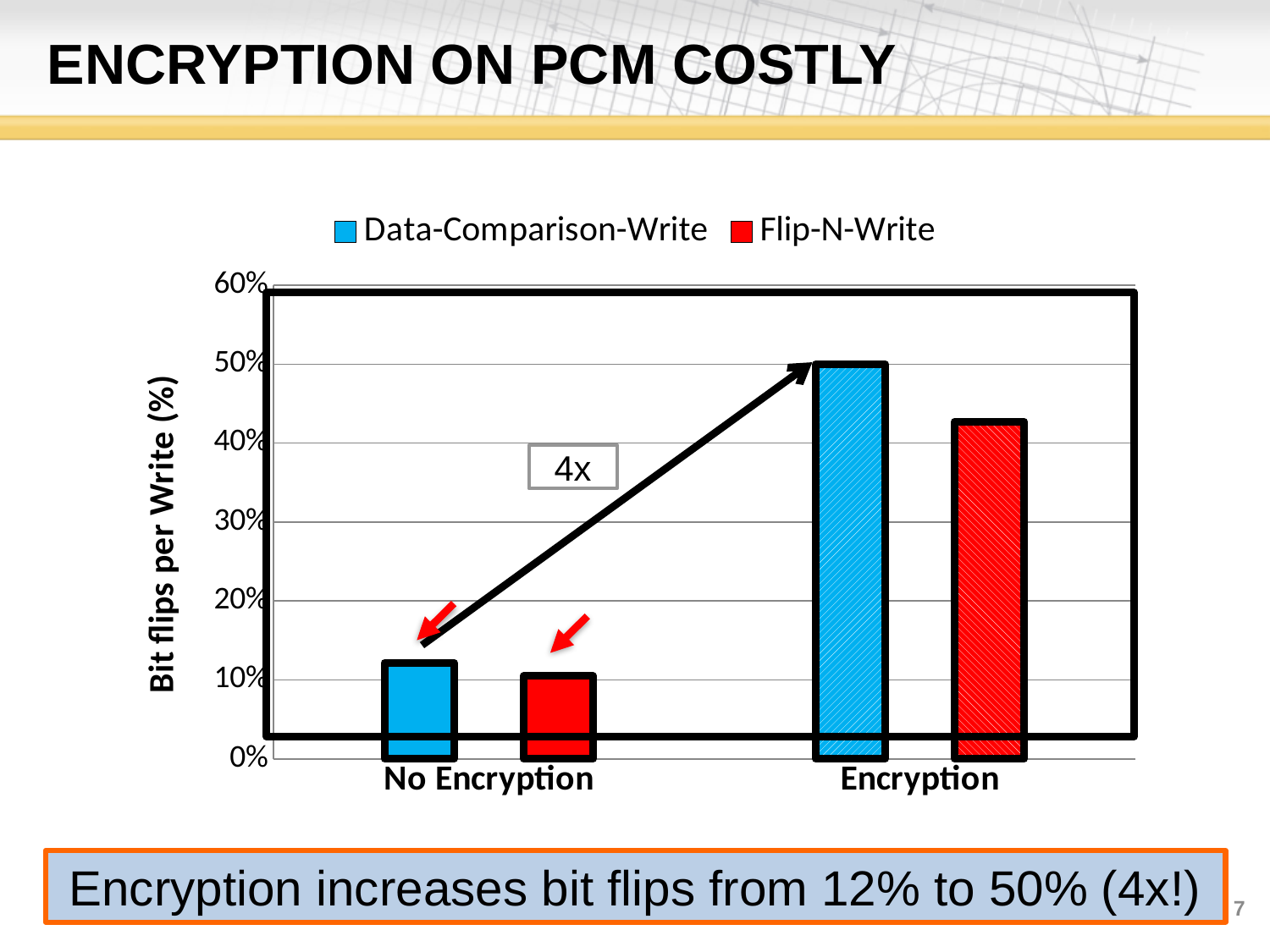
How many series does the legend list? 2 Which category has the highest Data-Comparison-Write value? Encryption How many categories are shown on the x axis? 2 Is the Flip-N-Write value for Encryption greater or less than 40%? greater For Encryption, which series has the larger value, Data-Comparison-Write or Flip-N-Write? Data-Comparison-Write Which colour represents Flip-N-Write in the legend? red Which category has the lowest Flip-N-Write value? No Encryption What kind of chart is shown on the slide? bar chart Is the Flip-N-Write value for No Encryption greater or less than 20%? less Is the Data-Comparison-Write value for No Encryption greater or less than 20%? less What is the Data-Comparison-Write value for Encryption? 50% What is the label of the y axis? Bit flips per Write (%)